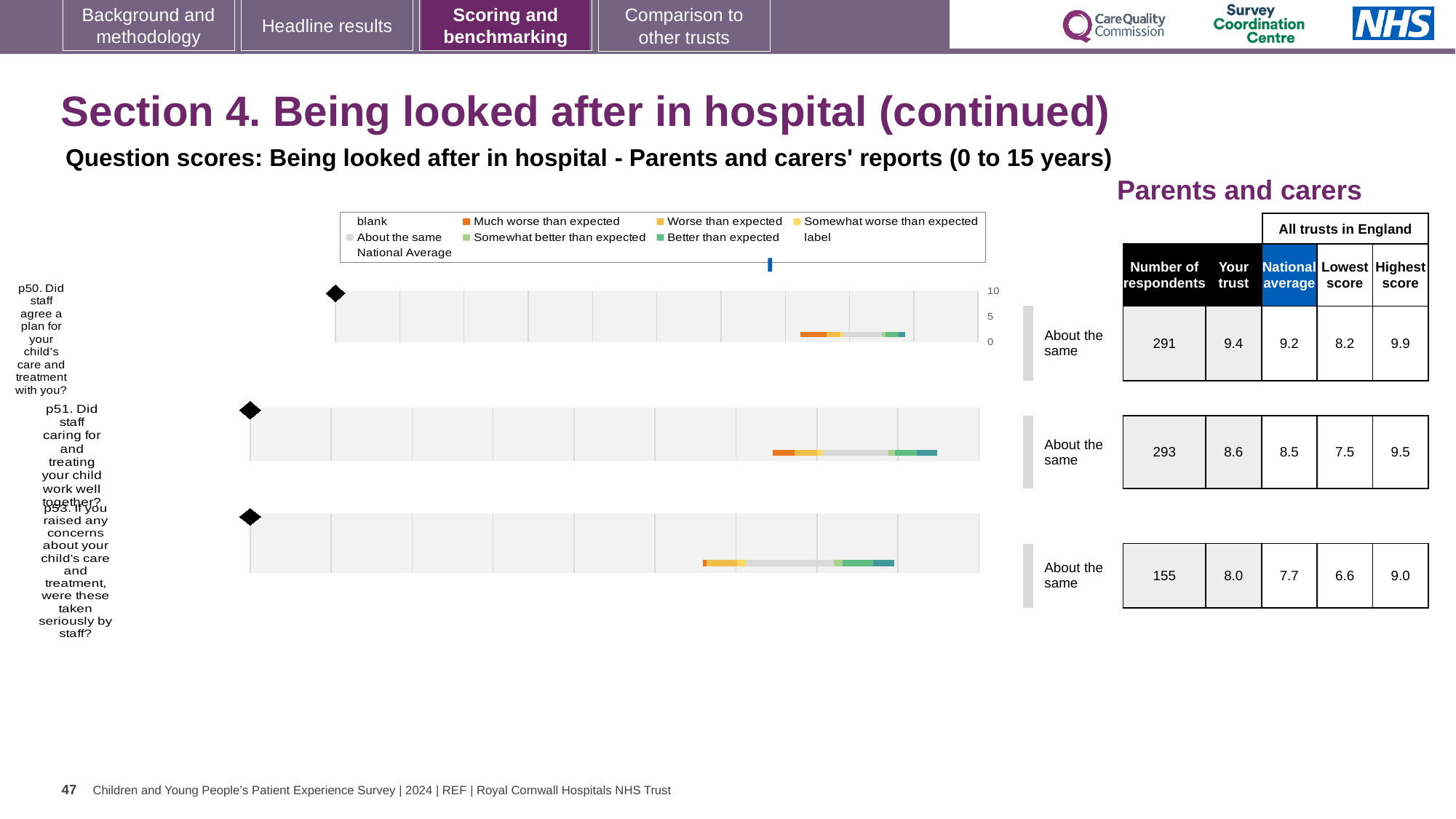
For p53, what is the lowest score among all trusts in England? 6.6 For p51, which is larger: the 'Your trust' score or the national average? Your trust How many questions (charts) are shown on the slide? 3 For p51 (Did staff caring for and treating your child work well together?), what is the national average score? 8.5 Which question has the highest 'Your trust' score? p50 Which question has the lowest 'Your trust' score? p53 What kind of chart is used for the p50, p51 and p53 question scores? bar chart For p53 (If you raised any concerns about your child's care and treatment, were these taken seriously by staff?), how many respondents were there? 155 For p50, what is the difference between the highest score and the lowest score among all trusts in England? 1.7 What benchmarking category is shown for p50? About the same For p50 (Did staff agree a plan for your child's care and treatment with you?), what is the 'Your trust' score? 9.4 For p53, how much higher is the 'Your trust' score than the national average? 0.3